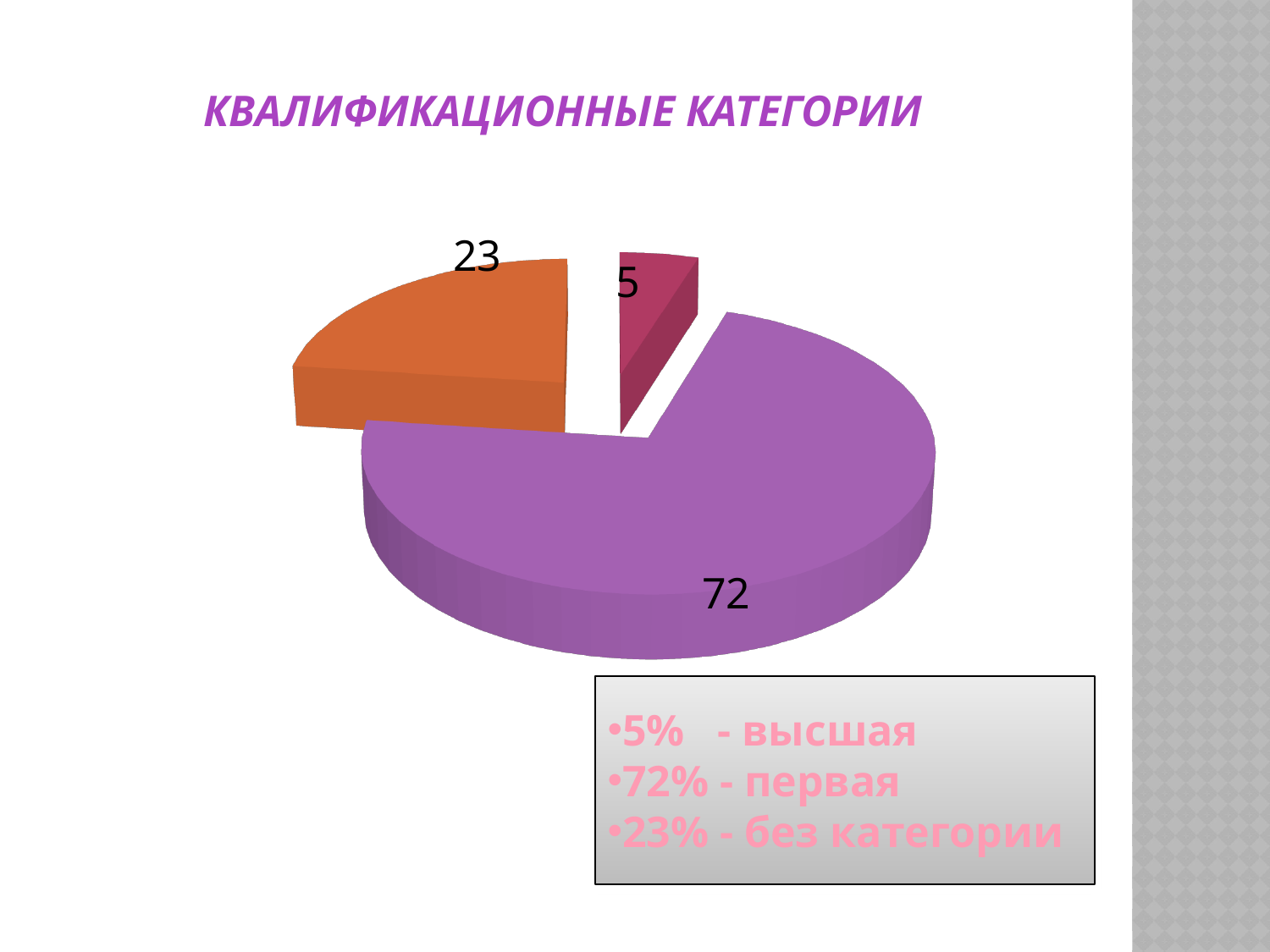
What is the value of the largest slice of the pie chart? 72 How many slices does the pie chart have? 3 According to the slide, what share corresponds to 'без категории'? 23% According to the slide, what share corresponds to the category 'высшая'? 5% What value is shown on the orange slice of the pie chart? 23 What is the difference between the values of the purple slice and the orange slice? 49 According to the slide, what share corresponds to the category 'первая'? 72% What is the value of the smallest slice of the pie chart? 5 What value is shown on the dark pink slice of the pie chart? 5 What kind of chart is shown on the slide? pie chart What is the title of the slide with the pie chart? КВАЛИФИКАЦИОННЫЕ КАТЕГОРИИ What value is shown on the purple slice of the pie chart? 72